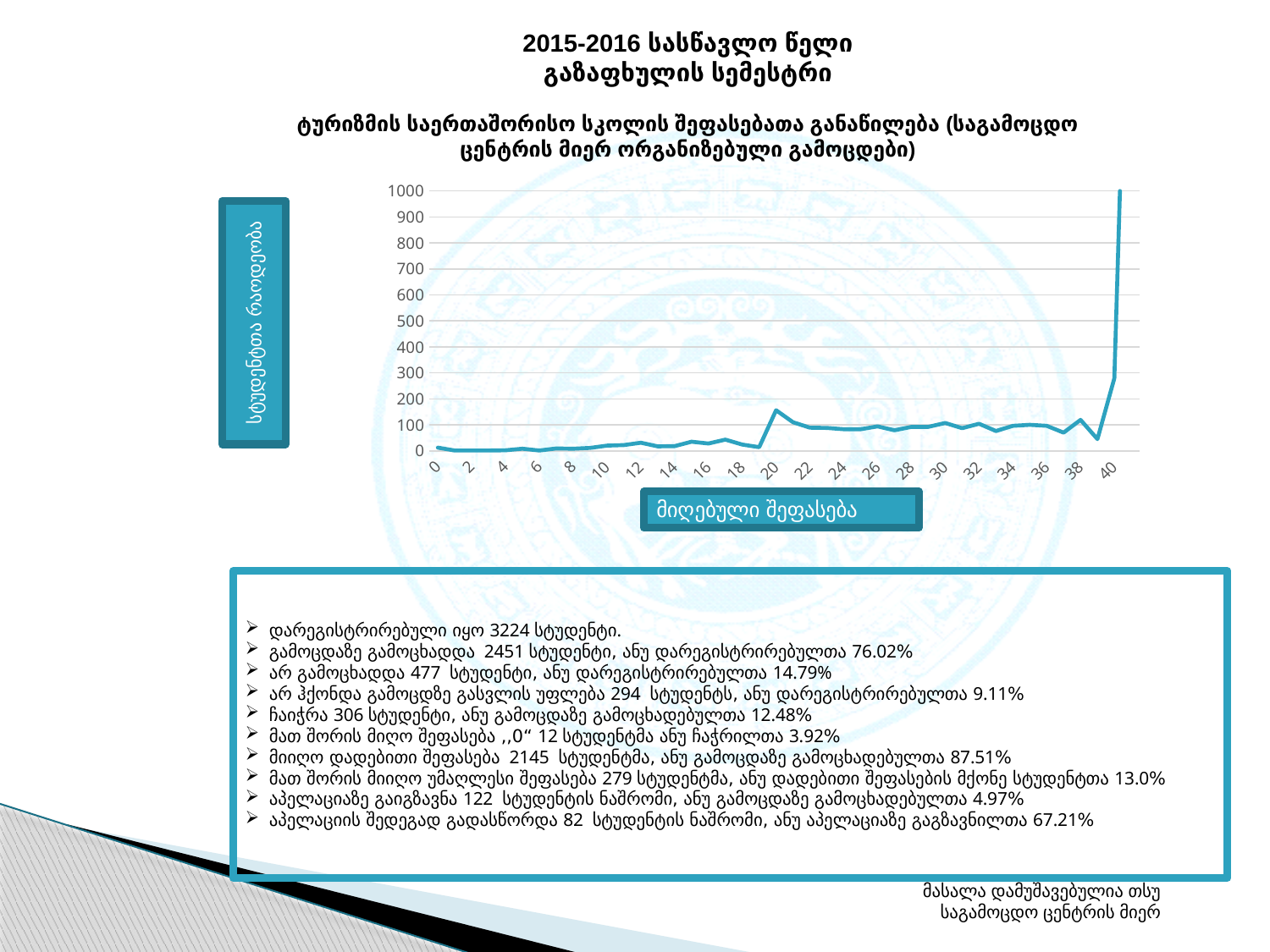
Is the number of students for score 20 greater or less than 100? greater What is the label of the x axis of the chart? მიღებული შეფასება Is the number of students for score 0 greater or less than 100? less Which score has more students, 40 or 20? 40 Is the number of students for score 10 greater or less than 100? less Overall, does the number of students rise or fall as the score increases along the x axis? rise Which score on the x axis has the highest number of students? 40 What kind of chart is shown on the slide? line chart What is the highest value shown on the y axis? 1000 Which score has more students, 20 or 10? 20